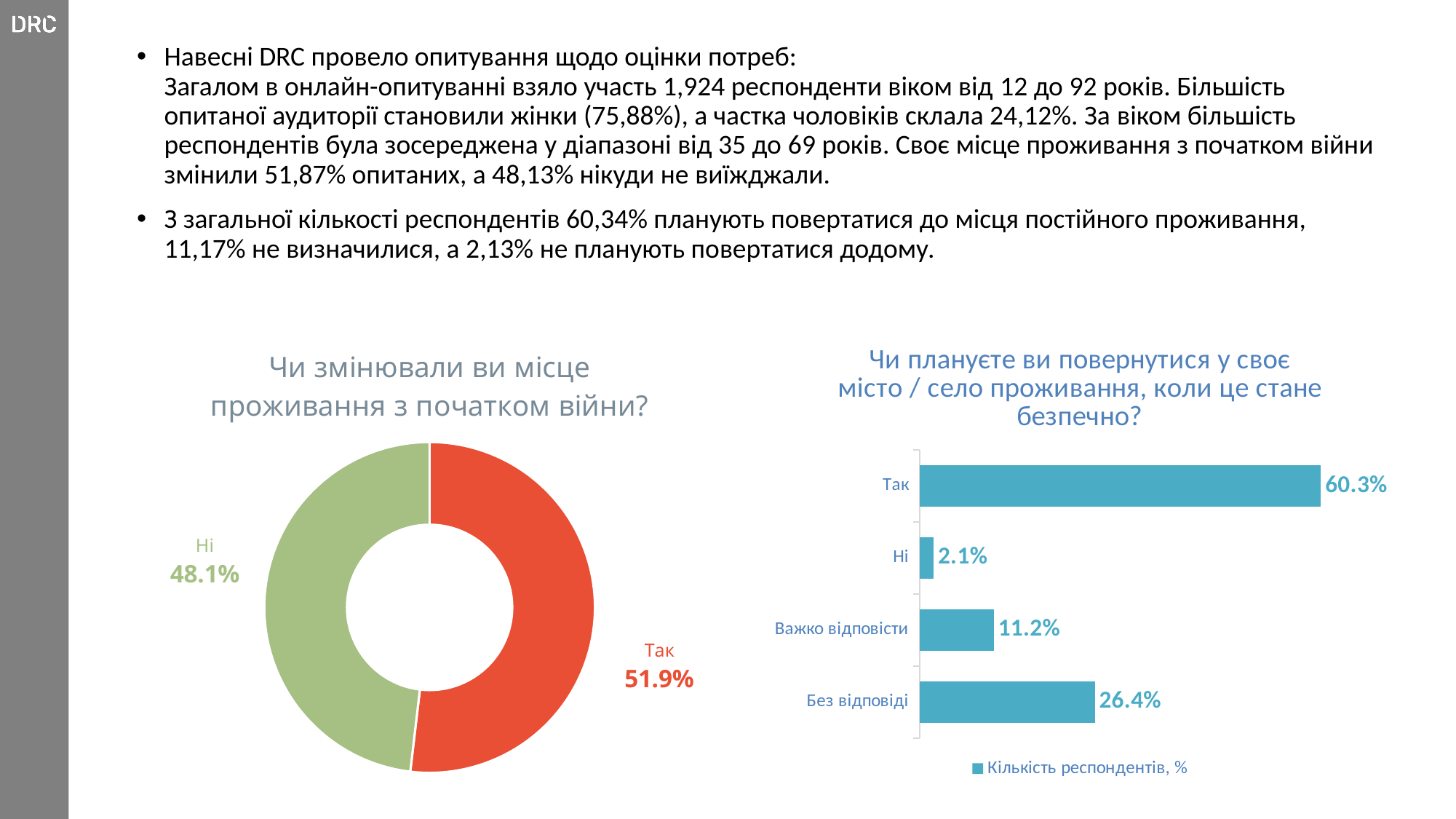
In the chart titled "Чи змінювали ви місце проживання з початком війни?", what share is labelled for "Так"? 51.9% What kind of chart is the one titled "Чи плануєте ви повернутися у своє місто / село проживання, коли це стане безпечно?"? Bar chart What kind of chart is the one titled "Чи змінювали ви місце проживання з початком війни?"? Donut chart What legend entry is shown under the chart titled "Чи плануєте ви повернутися у своє місто / село проживання, коли це стане безпечно?"? Кількість респондентів, % In the chart titled "Чи плануєте ви повернутися у своє місто / село проживання, коли це стане безпечно?", which category has the highest value? Так In the chart titled "Чи змінювали ви місце проживання з початком війни?", which slice is larger, "Так" or "Ні"? Так In the chart titled "Чи змінювали ви місце проживання з початком війни?", what share is labelled for "Ні"? 48.1% In the chart titled "Чи плануєте ви повернутися у своє місто / село проживання, коли це стане безпечно?", what is the value for "Без відповіді"? 26.4% In the chart titled "Чи плануєте ви повернутися у своє місто / село проживання, коли це стане безпечно?", what is the difference between "Так" and "Без відповіді"? 33.9% How many categories are shown in the chart titled "Чи плануєте ви повернутися у своє місто / село проживання, коли це стане безпечно?"? 4 In the chart titled "Чи плануєте ви повернутися у своє місто / село проживання, коли це стане безпечно?", which category has the lowest value? Ні In the chart titled "Чи плануєте ви повернутися у своє місто / село проживання, коли це стане безпечно?", what is the value for "Так"? 60.3%